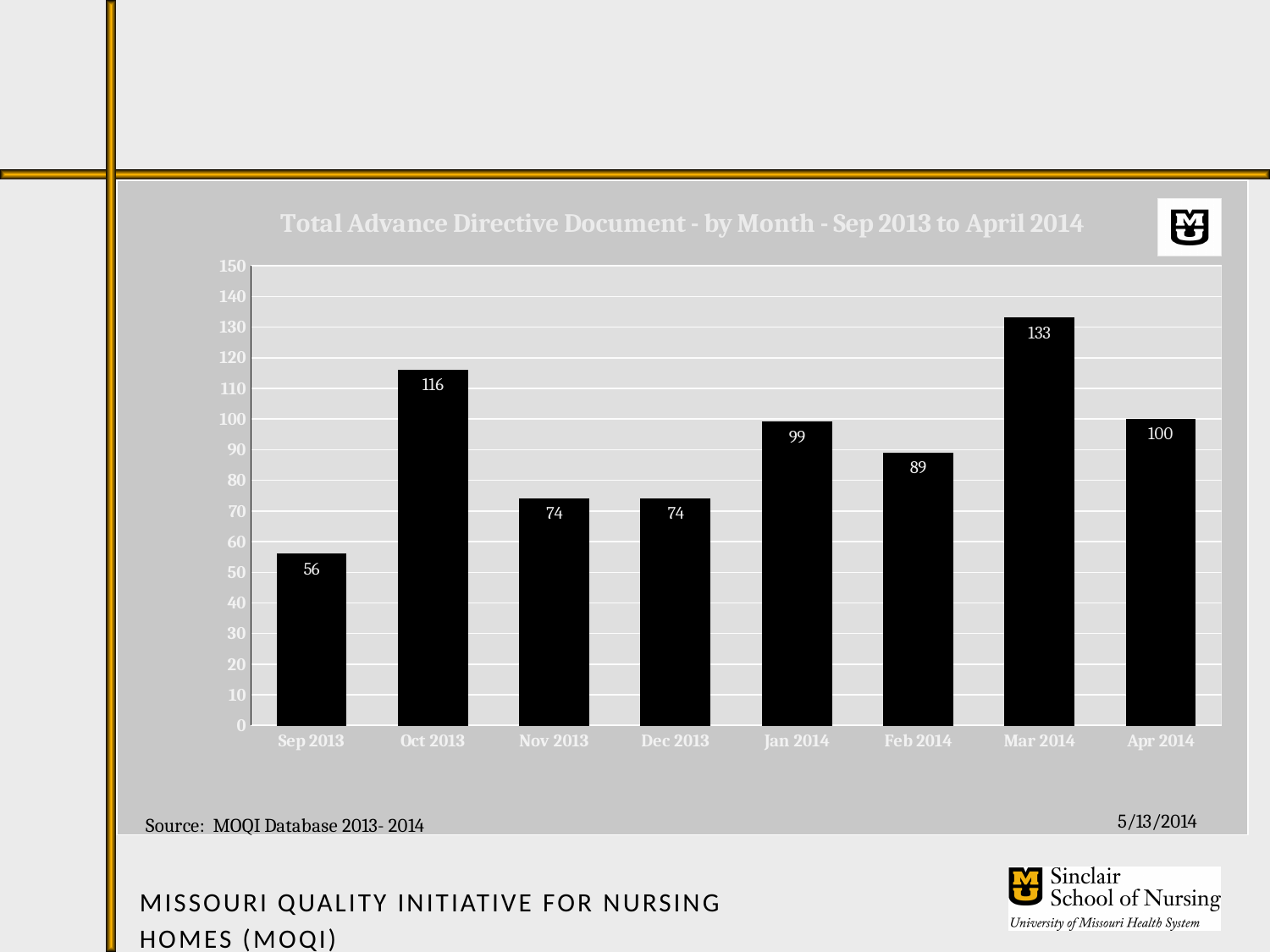
Which month has the lowest value? Sep 2013 How many months are shown on the x axis? 8 Is the value for Mar 2014 greater or less than 120? greater What kind of chart is shown on the slide? Bar chart What is the difference between the values for Oct 2013 and Nov 2013? 42 What is the value for Apr 2014? 100 Which month has the highest value? Mar 2014 Which is larger, the value for Jan 2014 or the value for Feb 2014? Jan 2014 What is the value for Feb 2014? 89 What is the value for Oct 2013? 116 What is the difference between the values for Mar 2014 and Sep 2013? 77 What is the title of the chart? Total Advance Directive Document - by Month - Sep 2013 to April 2014